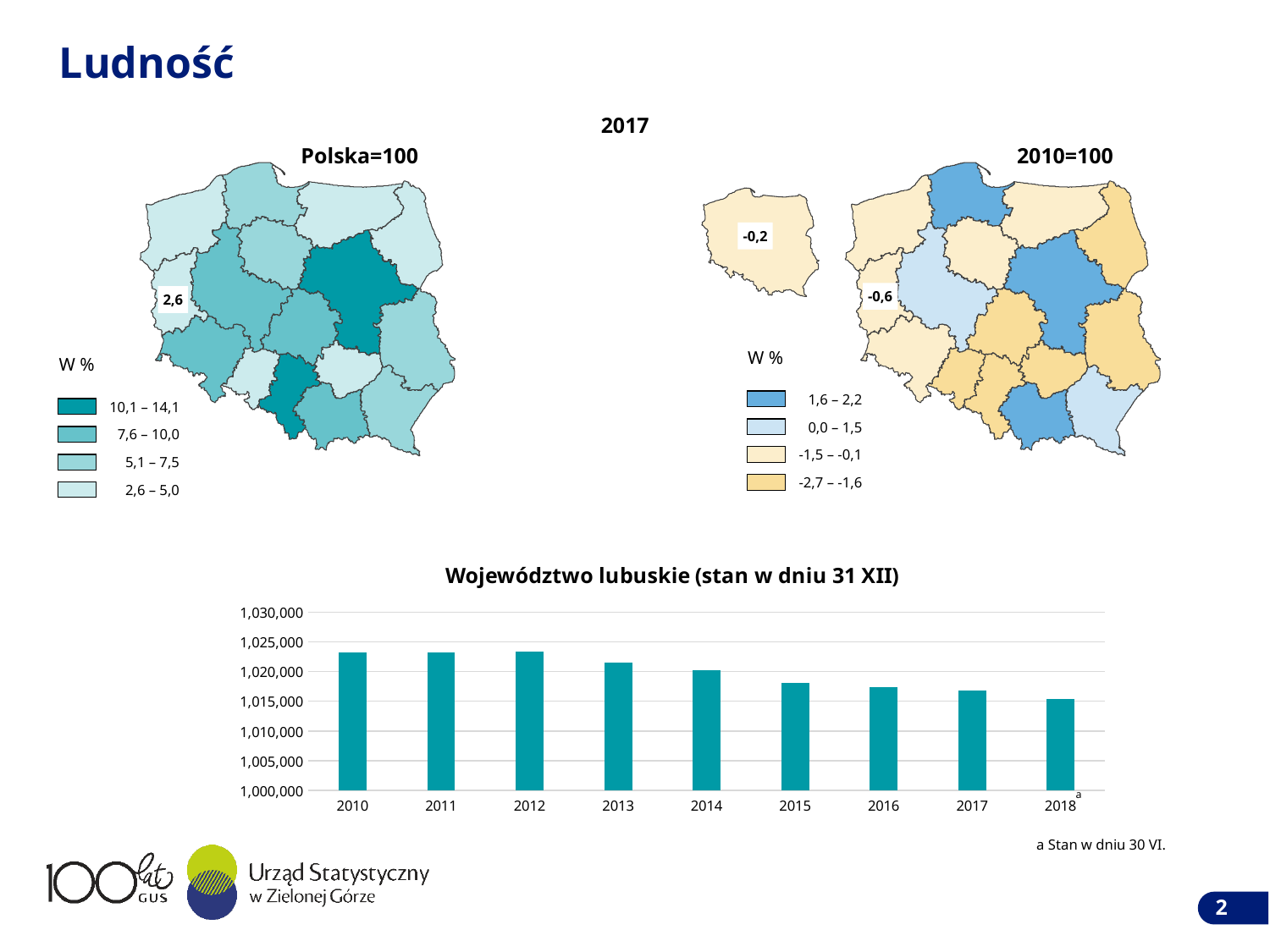
On the right map (2010=100), what is the highest range shown in the legend? 1,6 – 2,2 On the left map (Polska=100), what value is printed on the highlighted voivodeship? 2,6 On the right map (2010=100), what value is printed on the small inset map of Poland? -0,2 In the chart 'Województwo lubuskie (stan w dniu 31 XII)', which year has the lowest bar? 2018 What kind of chart is 'Województwo lubuskie (stan w dniu 31 XII)'? bar chart In the chart 'Województwo lubuskie (stan w dniu 31 XII)', is the value for 2018 greater or less than 1,020,000? less In the chart 'Województwo lubuskie (stan w dniu 31 XII)', how many years are shown on the x axis? 9 In the chart 'Województwo lubuskie (stan w dniu 31 XII)', which is larger, the value for 2010 or the value for 2018? 2010 In the chart 'Województwo lubuskie (stan w dniu 31 XII)', is the value for 2015 greater or less than 1,020,000? less In the chart 'Województwo lubuskie (stan w dniu 31 XII)', is the value for 2010 greater or less than 1,020,000? greater In the chart 'Województwo lubuskie (stan w dniu 31 XII)', do the values rise or fall from 2010 to 2018? fall